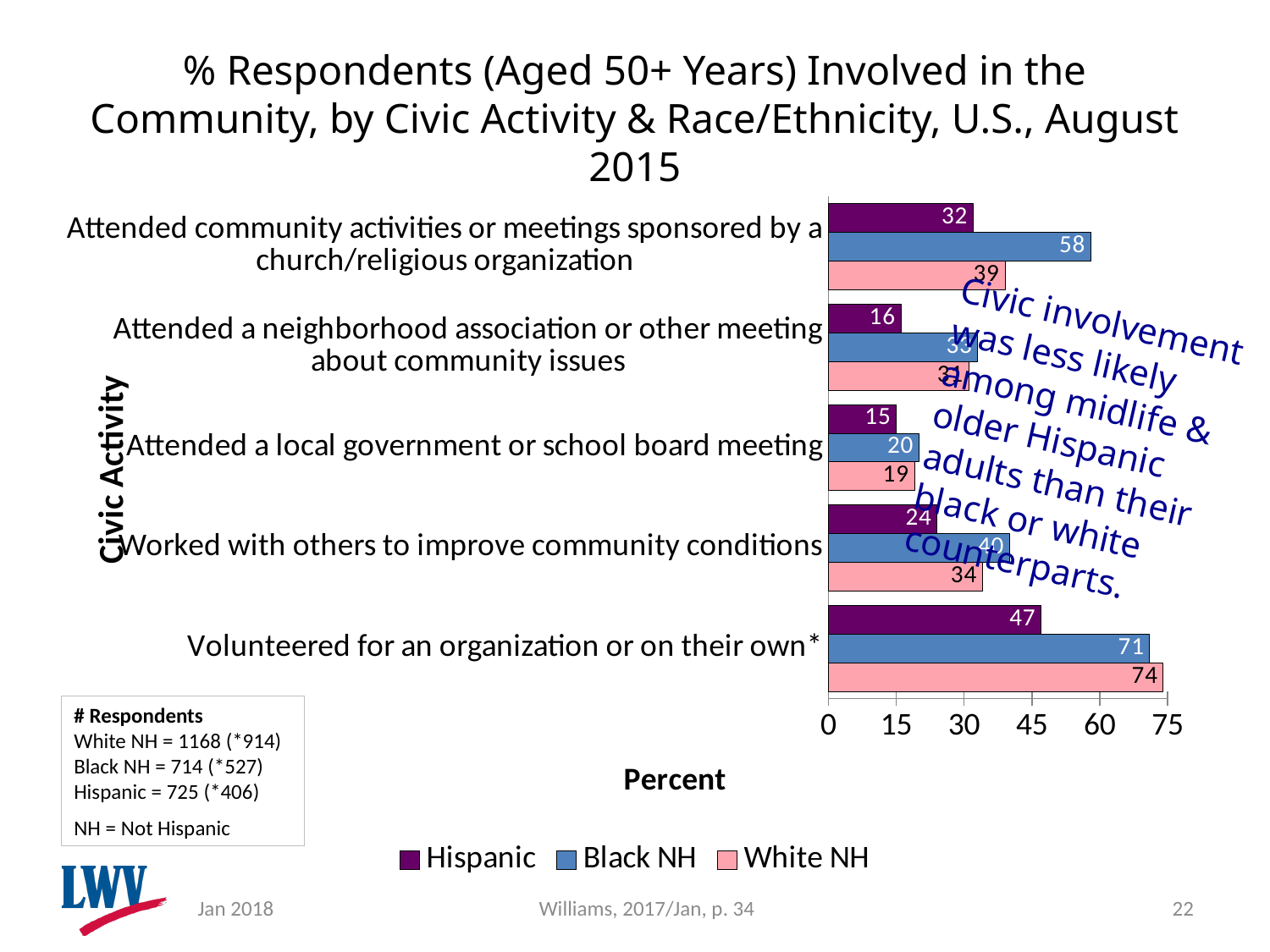
What type of chart is shown on the slide? bar chart What percentage of Black NH respondents attended community activities or meetings sponsored by a church/religious organization? 58 What is the value for White NH respondents who attended a local government or school board meeting? 19 For which civic activity is the Hispanic value lowest? Attended a local government or school board meeting What percentage of Hispanic respondents volunteered for an organization or on their own? 47 For volunteering for an organization or on their own, which is larger: the Black NH value or the White NH value? White NH How many civic activities are shown on the chart? 5 For attending church-sponsored community activities, what is the difference between the Black NH and Hispanic values? 26 For which civic activity is the Black NH value highest? Volunteered for an organization or on their own For volunteering for an organization or on their own, how many percentage points higher is the White NH value than the Hispanic value? 27 How many series does the legend list? 3 Is the Black NH value for 'Worked with others to improve community conditions' greater or less than 30? greater